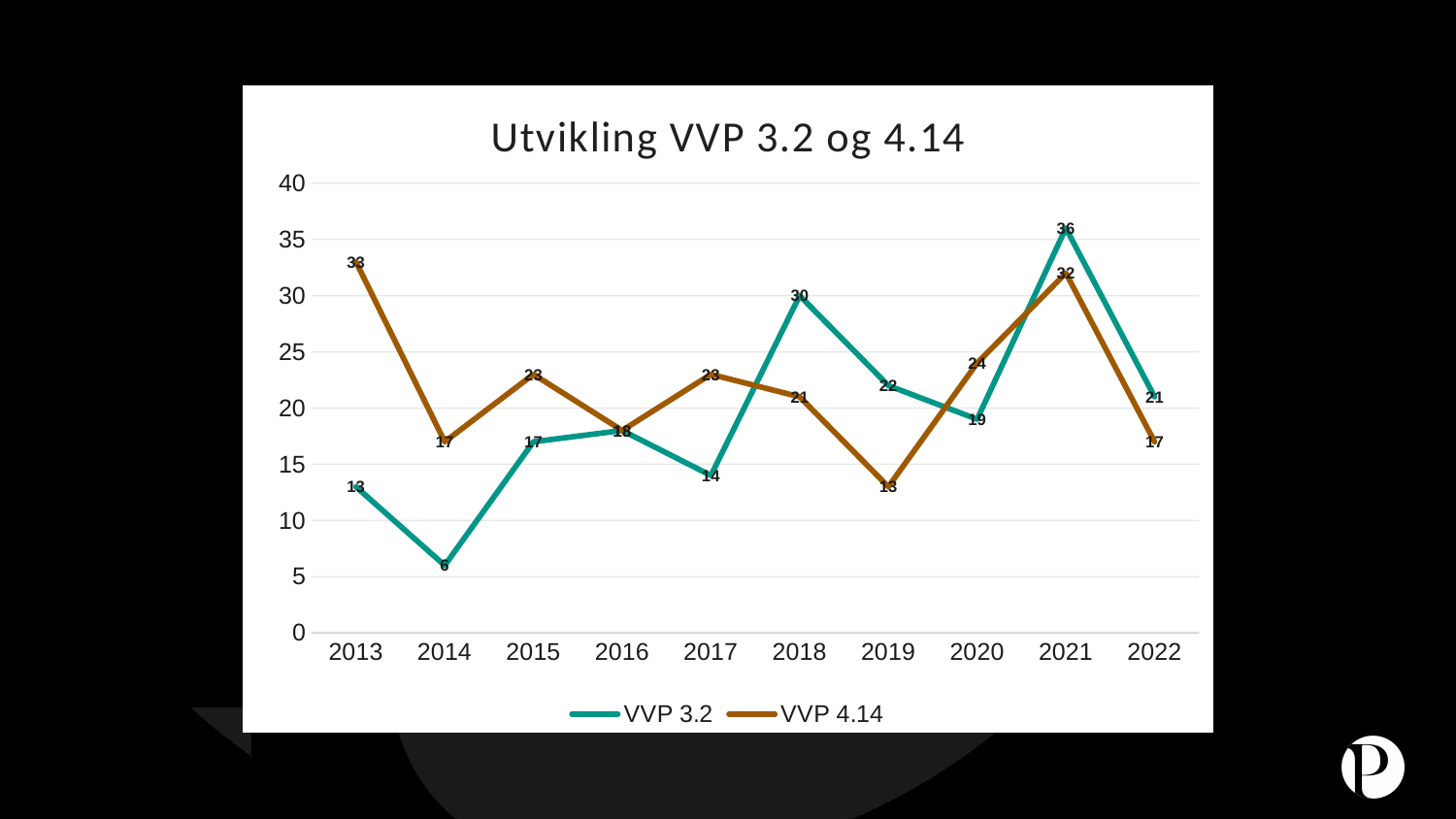
What is the difference between VVP 3.2 and VVP 4.14 in 2021? 4 In which year is VVP 3.2 highest? 2021 How many series does the legend list? 2 What is the value for VVP 3.2 in 2021? 36 In which year is VVP 4.14 highest? 2013 How many years are shown on the x axis? 10 What is the value for VVP 3.2 in 2014? 6 What kind of chart is shown on the slide? line chart In which year is VVP 3.2 lowest? 2014 What is the value for VVP 4.14 in 2013? 33 Which series has the larger value in 2018, VVP 3.2 or VVP 4.14? VVP 3.2 In which year is VVP 4.14 lowest? 2019